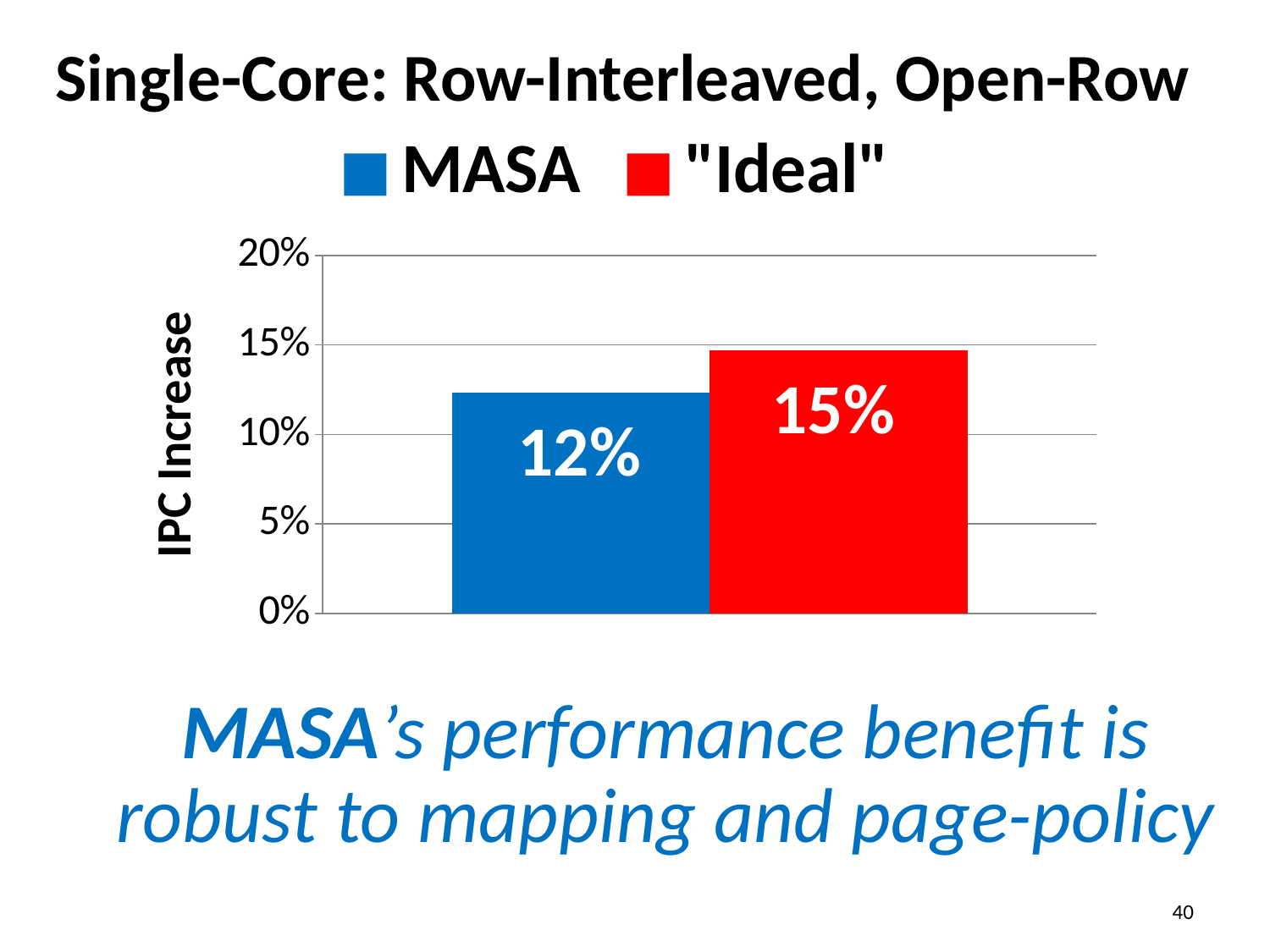
What is the IPC increase for MASA? 12% What colour is the bar for MASA? Blue What kind of chart is shown on the slide? Bar chart What is the label of the vertical axis? IPC Increase How many series does the legend list? 2 Is the IPC increase for "Ideal" greater or less than 20%? less What is the IPC increase for "Ideal"? 15% Which series has the higher IPC increase, MASA or "Ideal"? "Ideal" Is the IPC increase for MASA greater or less than 10%? greater Which series shows the lowest IPC increase? MASA Which series shows the highest IPC increase? "Ideal" What is the difference in IPC increase between "Ideal" and MASA? 2%